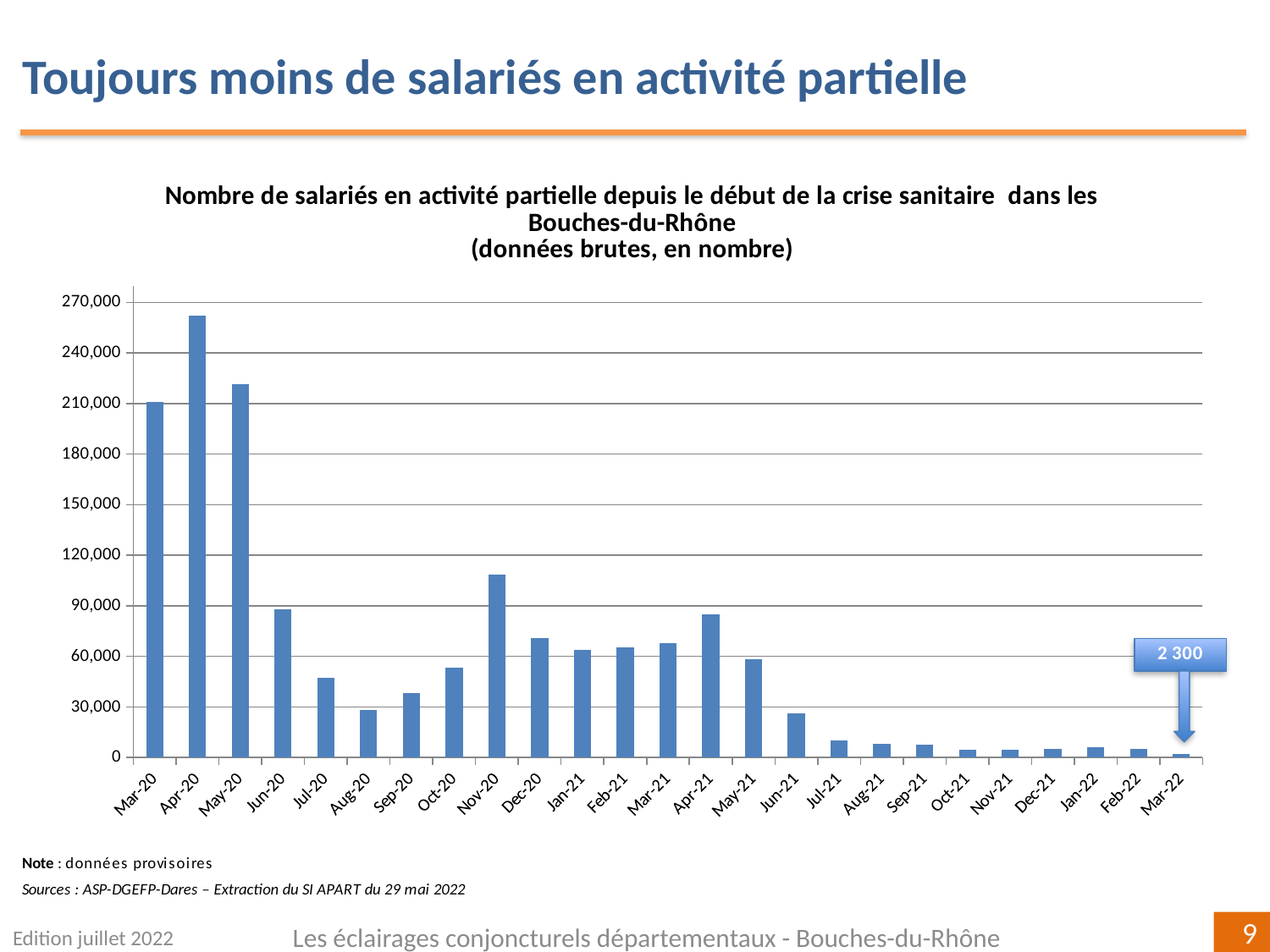
Which month has the lowest number of employees in partial activity? Mar-22 Is the value for Jul-21 greater or less than 30,000? less What kind of chart is shown on the slide? bar chart How many months are plotted on the x axis? 25 Which is larger, the value for Nov-20 or the value for Dec-20? Nov-20 What is the first month shown on the x axis of the chart? Mar-20 What is the number of employees in partial activity shown for Mar-22? 2 300 Which month has the highest number of employees in partial activity? Apr-20 Is the value for Apr-20 greater or less than 240,000? greater Is the value for Nov-20 greater or less than 90,000? greater Overall, do the values rise or fall from Mar-20 to Mar-22? fall Which is larger, the value for Mar-21 or the value for Apr-21? Apr-21